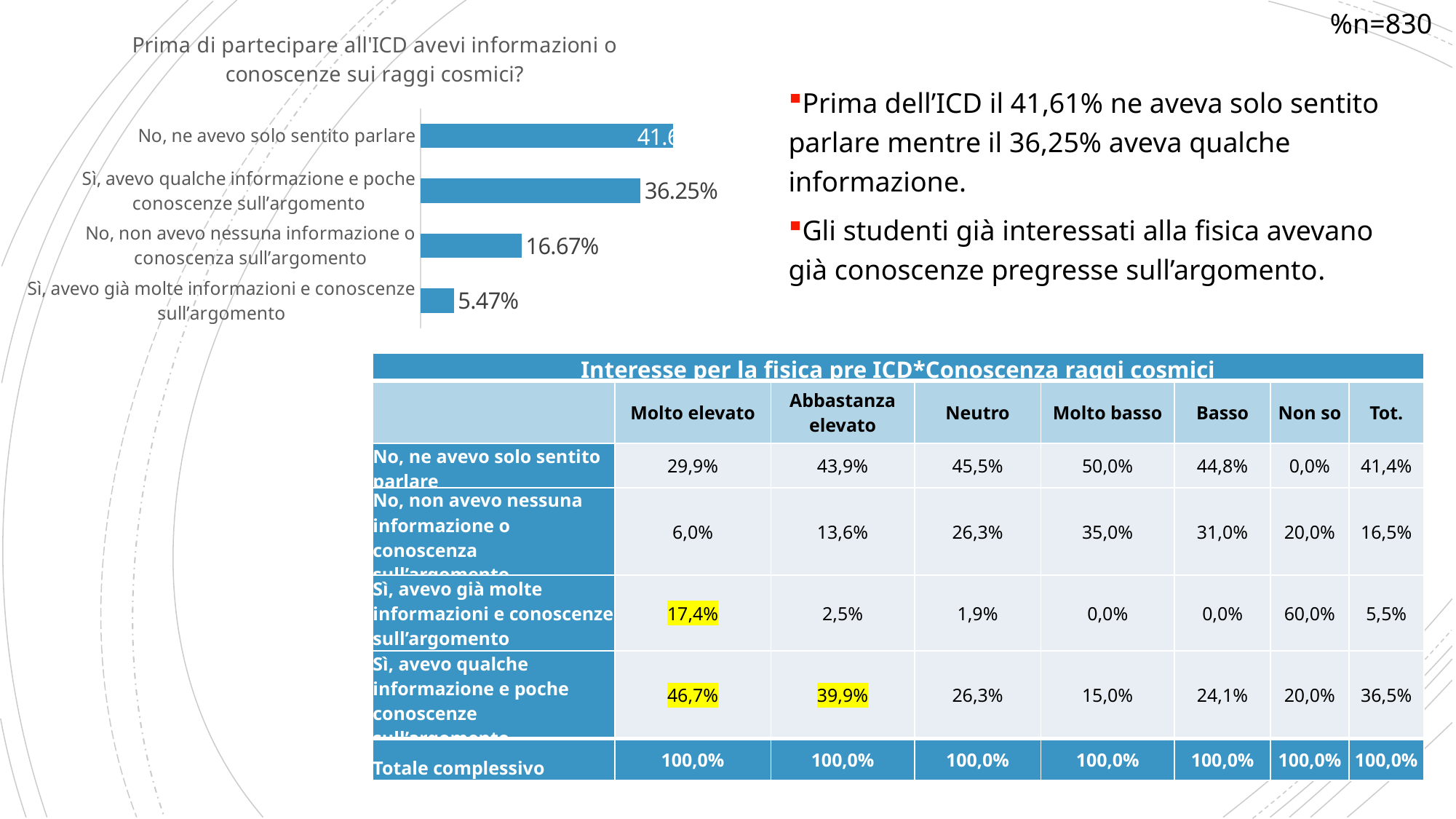
Which is larger in the bar chart: the value for 'No, non avevo nessuna informazione o conoscenza sull'argomento' or for 'Sì, avevo già molte informazioni e conoscenze sull'argomento'? No, non avevo nessuna informazione o conoscenza sull'argomento How many categories does the bar chart show? 4 Which category has the lowest value in the bar chart? Sì, avevo già molte informazioni e conoscenze sull'argomento What is the value for 'No, non avevo nessuna informazione o conoscenza sull'argomento' in the bar chart? 16.67% What kind of chart is shown on the slide? Bar chart Which category has the highest value in the bar chart? No, ne avevo solo sentito parlare What is the difference between the values for 'Sì, avevo qualche informazione e poche conoscenze sull'argomento' and 'No, non avevo nessuna informazione o conoscenza sull'argomento'? 19.58% Which is larger in the bar chart: the value for 'No, ne avevo solo sentito parlare' or for 'Sì, avevo qualche informazione e poche conoscenze sull'argomento'? No, ne avevo solo sentito parlare What is the difference between the values for 'No, non avevo nessuna informazione o conoscenza sull'argomento' and 'Sì, avevo già molte informazioni e conoscenze sull'argomento'? 11.20% What is the value for 'Sì, avevo qualche informazione e poche conoscenze sull'argomento' in the bar chart? 36.25% What is the title of the bar chart? Prima di partecipare all'ICD avevi informazioni o conoscenze sui raggi cosmici? What is the value for 'Sì, avevo già molte informazioni e conoscenze sull'argomento' in the bar chart? 5.47%